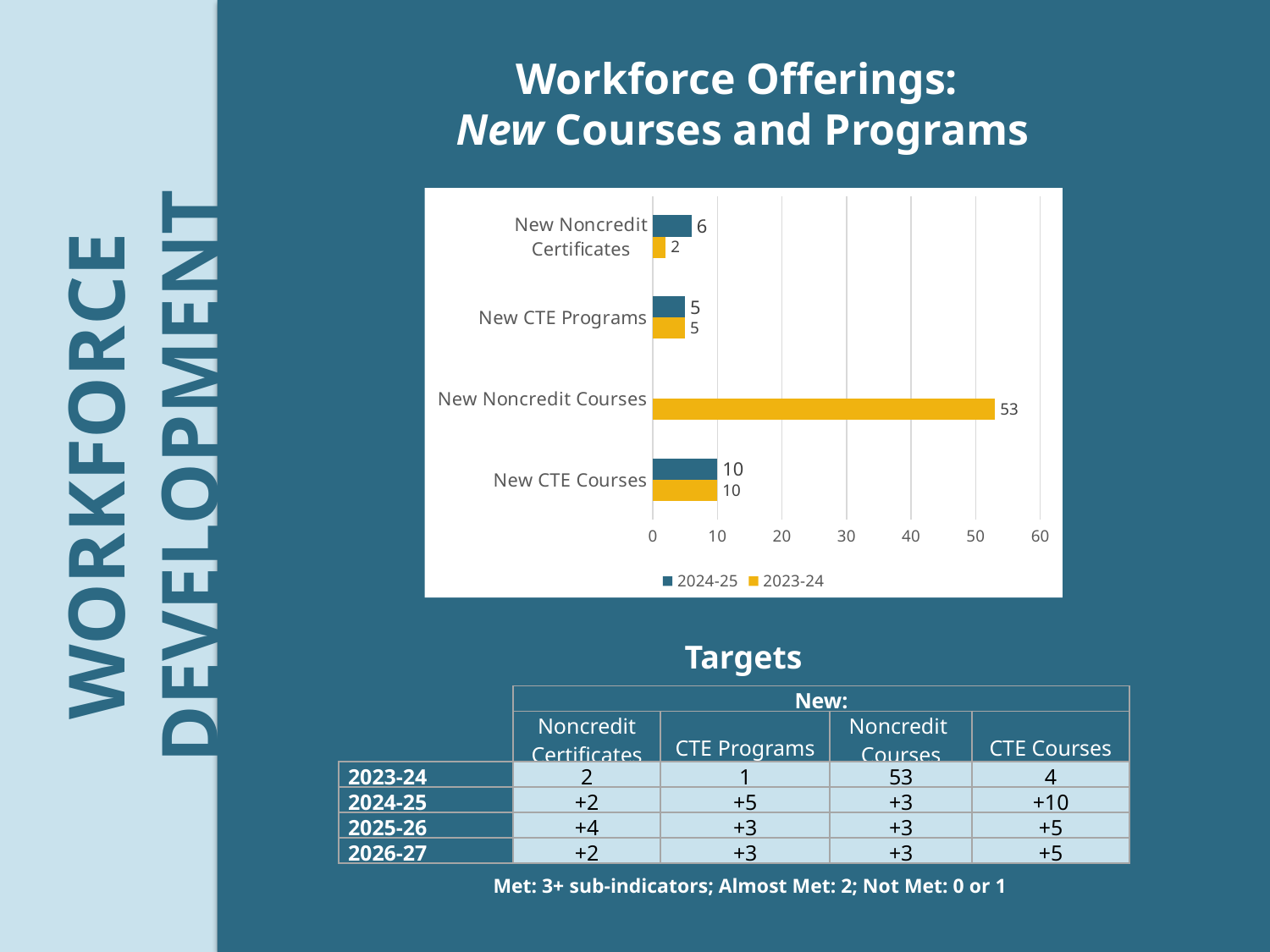
What is the 2023-24 value for New CTE Courses? 10 What is the 2023-24 value for New Noncredit Certificates? 2 Which category has the highest 2023-24 value? New Noncredit Courses Which is larger for New Noncredit Certificates: the 2024-25 value or the 2023-24 value? 2024-25 Which category has the lowest 2023-24 value? New Noncredit Certificates Is the 2023-24 value for New Noncredit Courses greater or less than 50? greater How many categories are shown on the chart? 4 What is the 2023-24 value for New Noncredit Courses? 53 What is the difference between the 2024-25 and 2023-24 values for New Noncredit Certificates? 4 What kind of chart is shown on the slide? Bar chart What is the 2024-25 value for New Noncredit Certificates? 6 How many series does the legend list? 2